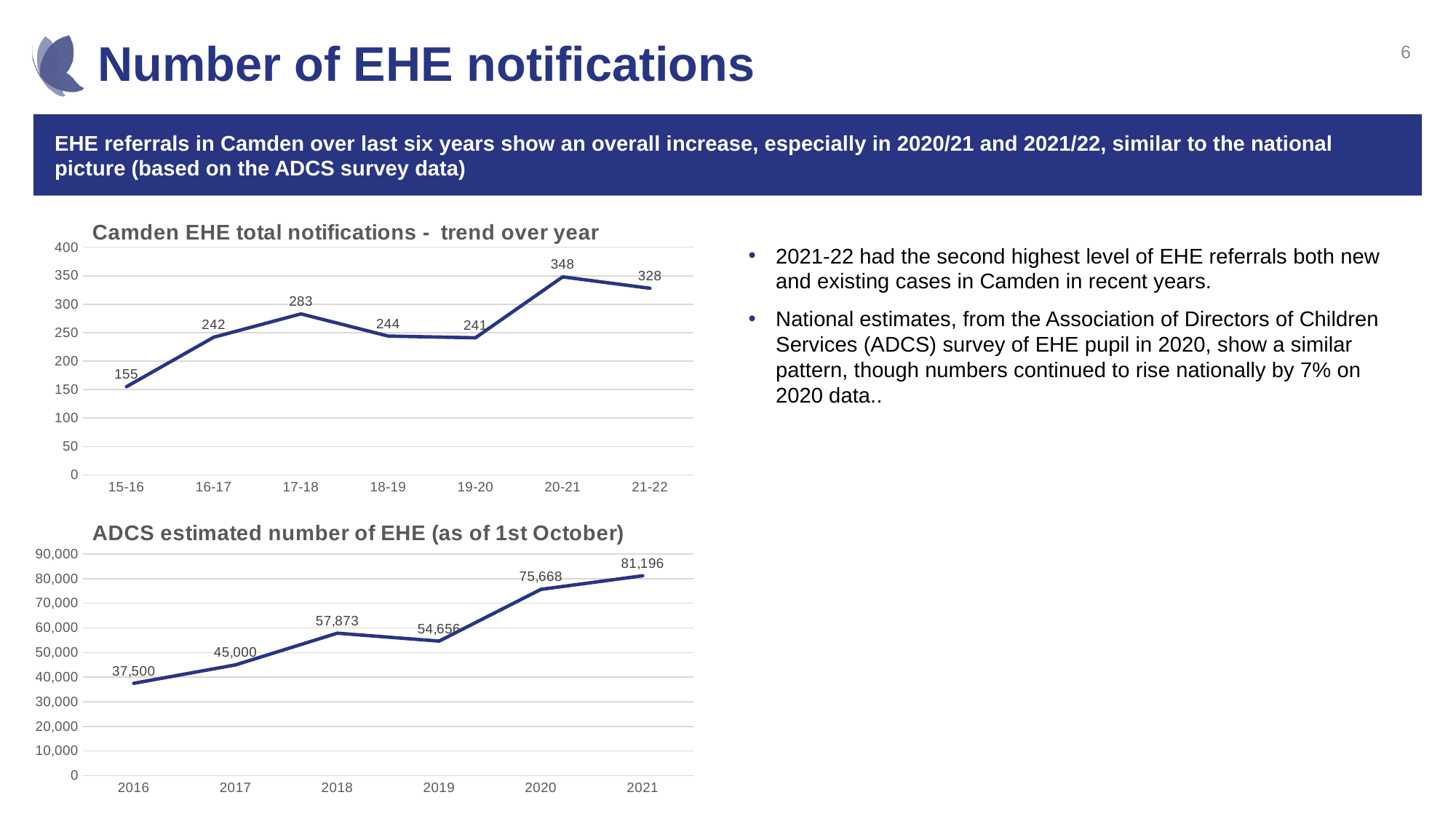
In the 'Camden EHE total notifications - trend over year' chart, which year has the lowest value? 15-16 In the 'ADCS estimated number of EHE (as of 1st October)' chart, which is larger, the value for 2018 or the value for 2019? 2018 In the 'Camden EHE total notifications - trend over year' chart, what is the value for 17-18? 283 What type of chart is the 'Camden EHE total notifications - trend over year' chart? Line chart In the 'Camden EHE total notifications - trend over year' chart, what is the difference between the values for 20-21 and 21-22? 20 In the 'Camden EHE total notifications - trend over year' chart, how many years are plotted? 7 In the 'ADCS estimated number of EHE (as of 1st October)' chart, what is the value for 2019? 54,656 In the 'ADCS estimated number of EHE (as of 1st October)' chart, how many years are plotted? 6 In the 'ADCS estimated number of EHE (as of 1st October)' chart, what is the difference between the values for 2021 and 2020? 5,528 In the 'ADCS estimated number of EHE (as of 1st October)' chart, which year has the highest value? 2021 In the 'ADCS estimated number of EHE (as of 1st October)' chart, do the values generally rise or fall from 2016 to 2021? Rise In the 'Camden EHE total notifications - trend over year' chart, which year has the highest value? 20-21